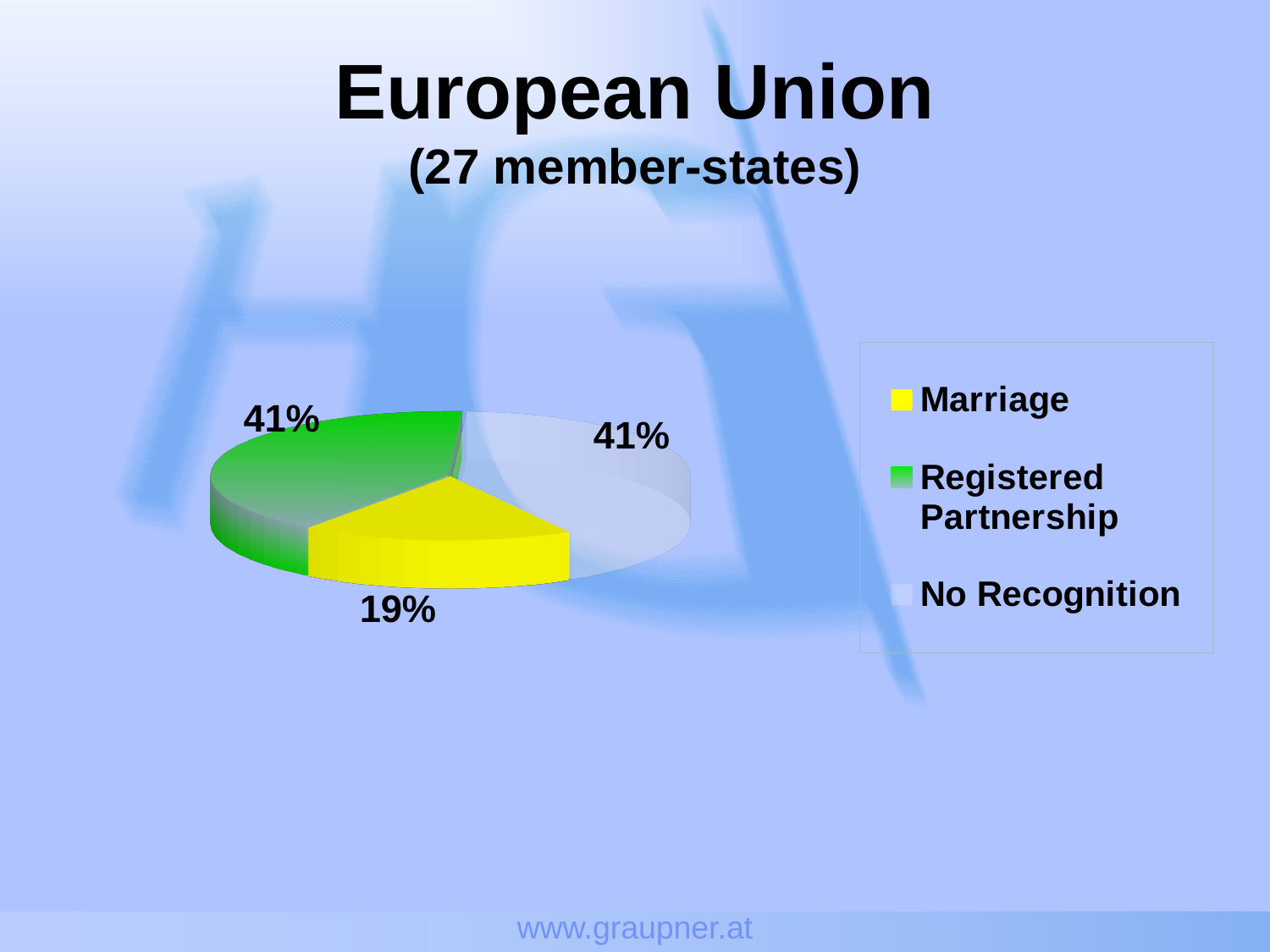
What percentage of the pie chart is labelled for No Recognition? 41% How many entries does the legend list? 3 Which colour represents Marriage in the legend? Yellow What share of the pie does the Marriage slice represent? 19% What kind of chart is shown on the slide? Pie chart What percentage of the pie chart is labelled for Marriage? 19% Which is larger: the slice for Marriage or the slice for Registered Partnership? Registered Partnership What percentage of the pie chart is labelled for Registered Partnership? 41% How many slices does the pie chart have? 3 Which category has the smallest slice of the pie chart? Marriage Which is larger: the slice for No Recognition or the slice for Marriage? No Recognition What is the difference in percentage points between the Registered Partnership slice and the Marriage slice? 22